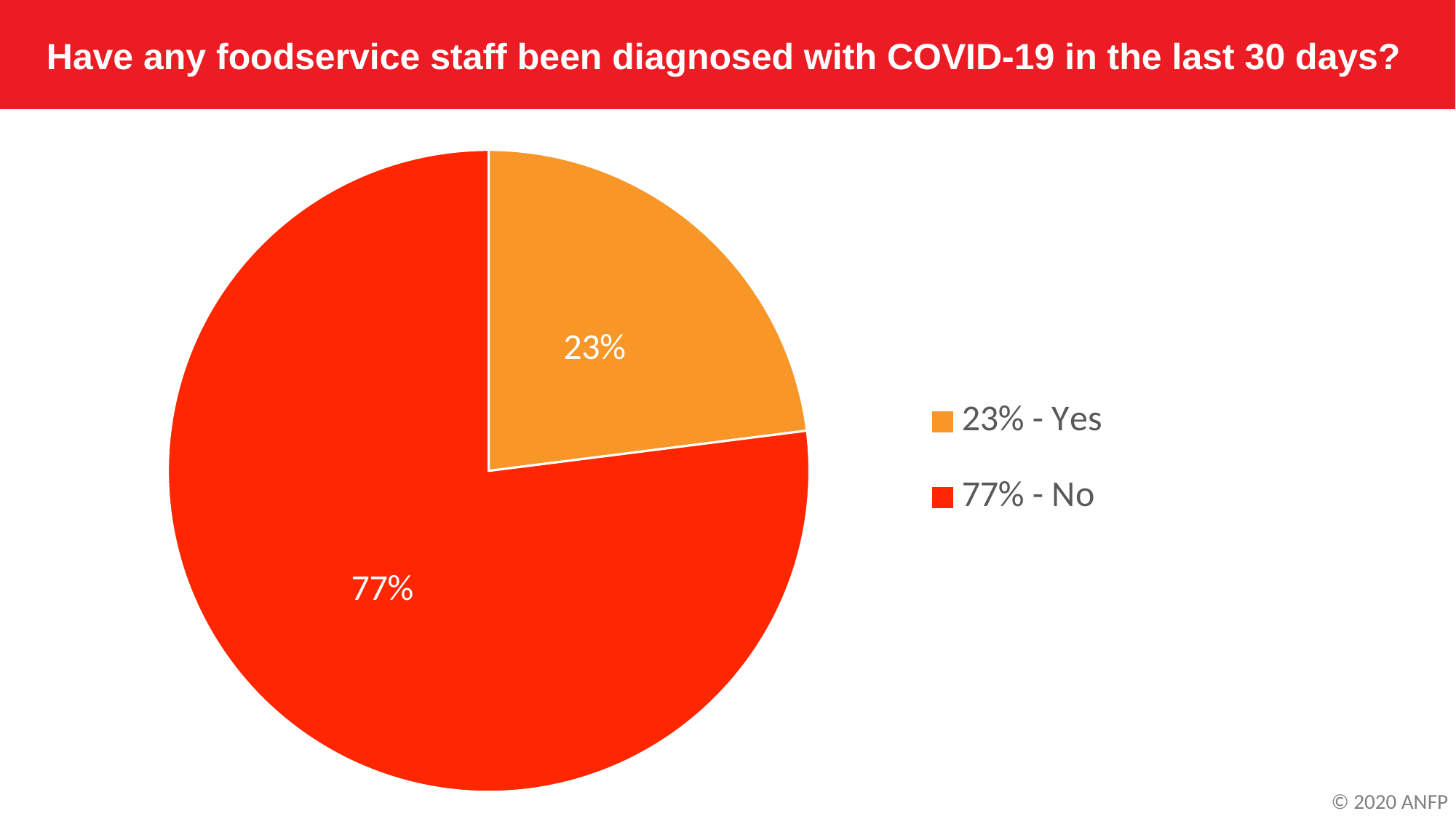
Which response has the largest share of the pie? No What is the difference in percentage points between the No and Yes responses? 54 What share of the pie does the Yes slice represent? 23% What is the title of the chart? Have any foodservice staff been diagnosed with COVID-19 in the last 30 days? What kind of chart is shown on the slide? pie chart How many slices does the pie chart have? 2 How many entries does the legend list? 2 What percentage of respondents answered Yes? 23% What colour is the slice for No? red What percentage of respondents answered No? 77% Which is larger, the share for Yes or the share for No? No Which response has the smallest share of the pie? Yes